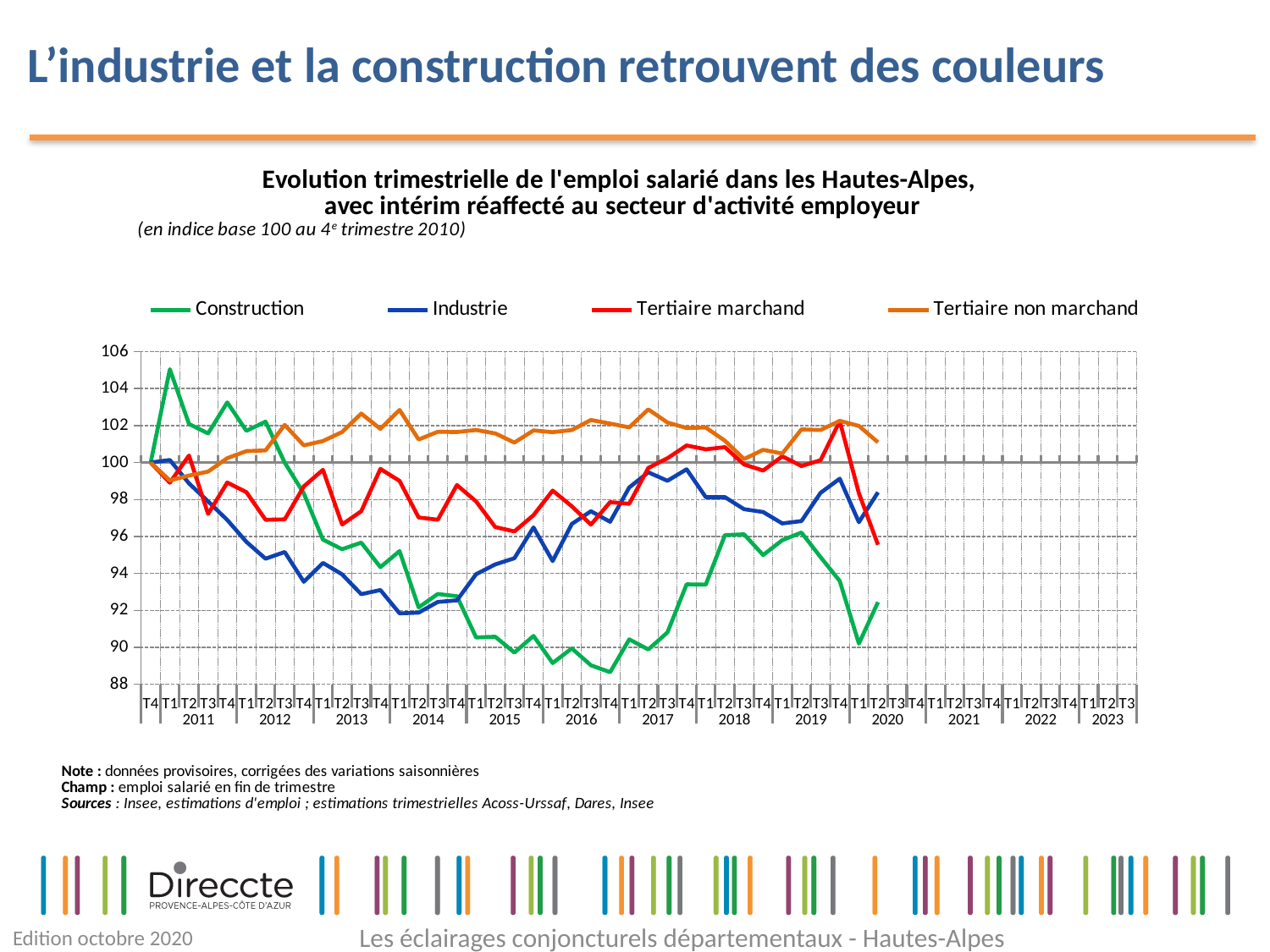
Is the value for Construction at T4 2016 greater or less than 90? less Is the value for Tertiaire non marchand at T3 2013 greater or less than 102? greater At T2 2020, which series has the lowest value? Construction What kind of chart is shown on the slide? line chart What is the index value of all four series at T4 2010, the base quarter? 100 At T2 2020, which series has the highest value? Tertiaire non marchand How many series does the legend list? 4 Does the Construction series rise or fall between T1 2011 and T4 2016? fall At T2 2020, which is larger: the value for Industrie or the value for Construction? Industrie Is the value for Tertiaire marchand at T2 2020 greater or less than 98? less Which series is shown in green in the legend? Construction